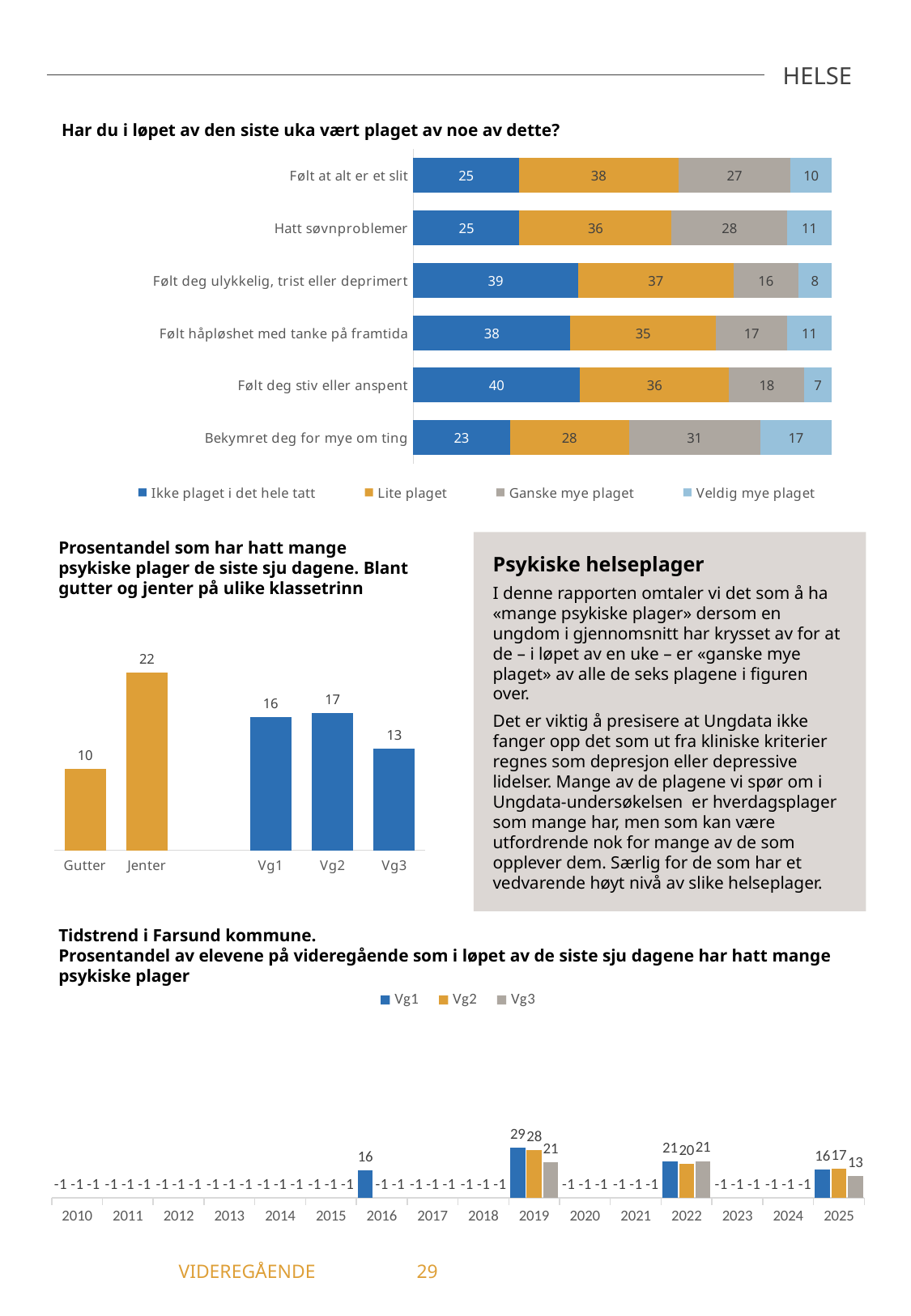
In the chart 'Tidstrend i Farsund kommune', what is the value for Vg1 in 2019? 29 In the chart 'Prosentandel som har hatt mange psykiske plager de siste sju dagene', what is the value for Jenter? 22 In the chart 'Prosentandel som har hatt mange psykiske plager de siste sju dagene', which category has the lowest value? Gutter In the chart 'Tidstrend i Farsund kommune', which is larger in 2025: Vg2 or Vg3? Vg2 In the chart 'Prosentandel som har hatt mange psykiske plager de siste sju dagene', what is the difference between Jenter and Gutter? 12 In the chart 'Har du i løpet av den siste uka vært plaget av noe av dette?', what is the value for 'Veldig mye plaget' in the 'Bekymret deg for mye om ting' bar? 17 In the chart 'Har du i løpet av den siste uka vært plaget av noe av dette?', which category has the highest value for 'Ikke plaget i det hele tatt'? Følt deg stiv eller anspent In the chart 'Har du i løpet av den siste uka vært plaget av noe av dette?', how many categories are shown? 6 In the chart 'Har du i løpet av den siste uka vært plaget av noe av dette?', what is the total of the 'Følt at alt er et slit' bar? 100 In the chart 'Har du i løpet av den siste uka vært plaget av noe av dette?', what is the value for 'Lite plaget' in the 'Hatt søvnproblemer' bar? 36 In the chart 'Har du i løpet av den siste uka vært plaget av noe av dette?', how many series does the legend list? 4 What kind of chart is 'Tidstrend i Farsund kommune'? Bar chart